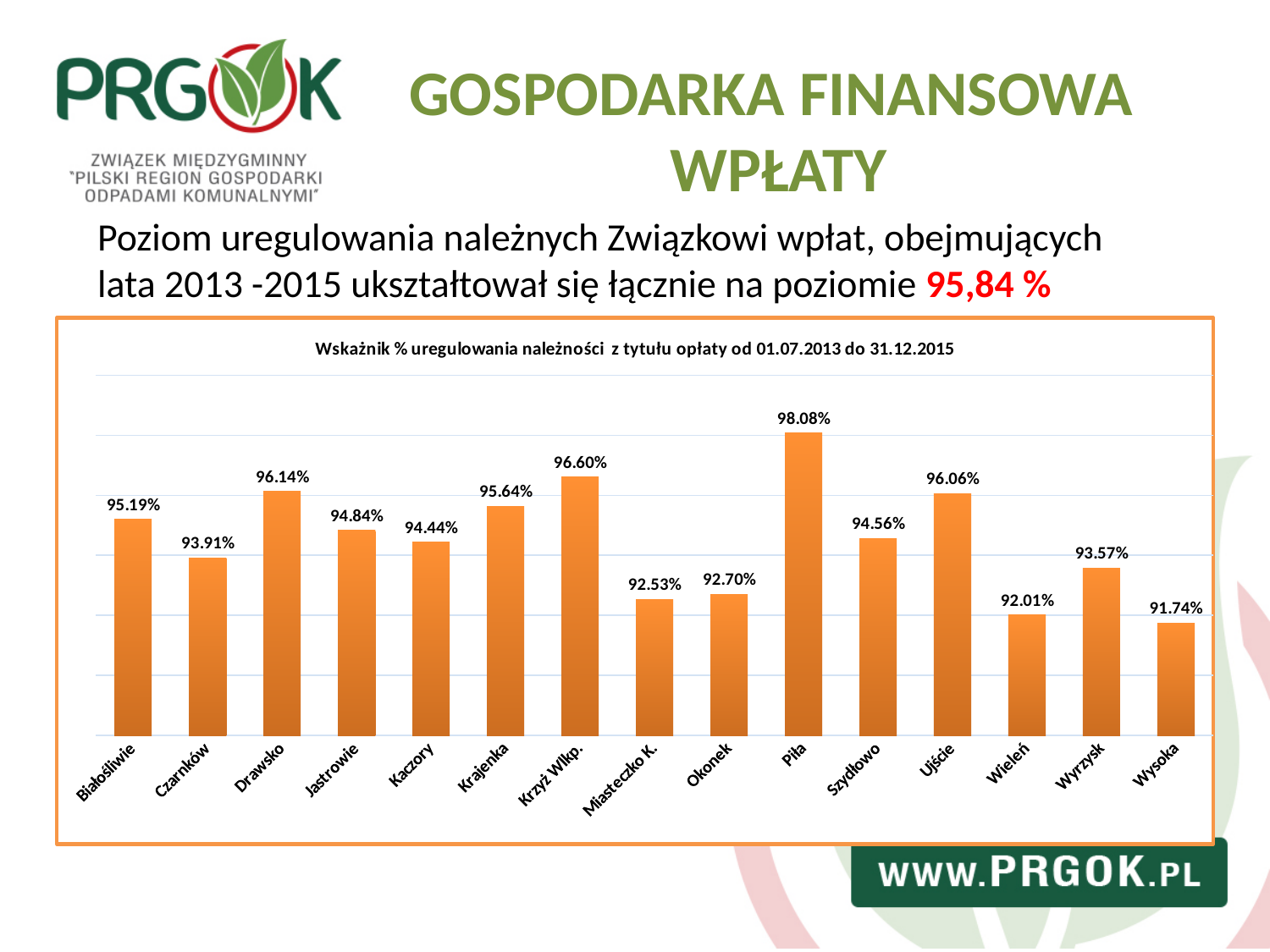
What is the difference between the values for Piła and Wysoka? 6.34 percentage points What kind of chart is shown on the slide? Bar chart What is the title of the chart? Wskaźnik % uregulowania należności z tytułu opłaty od 01.07.2013 do 31.12.2015 Which category has the highest value? Piła What is the value for Wieleń? 92.01% What is the value for Piła? 98.08% Which category has the lowest value? Wysoka What is the difference between the values for Drawsko and Czarnków? 2.23 percentage points How many categories are shown on the x axis? 15 What is the value for Czarnków? 93.91% Which is larger, the value for Ujście or the value for Szydłowo? Ujście What is the value for Krzyż Wlkp.? 96.60%